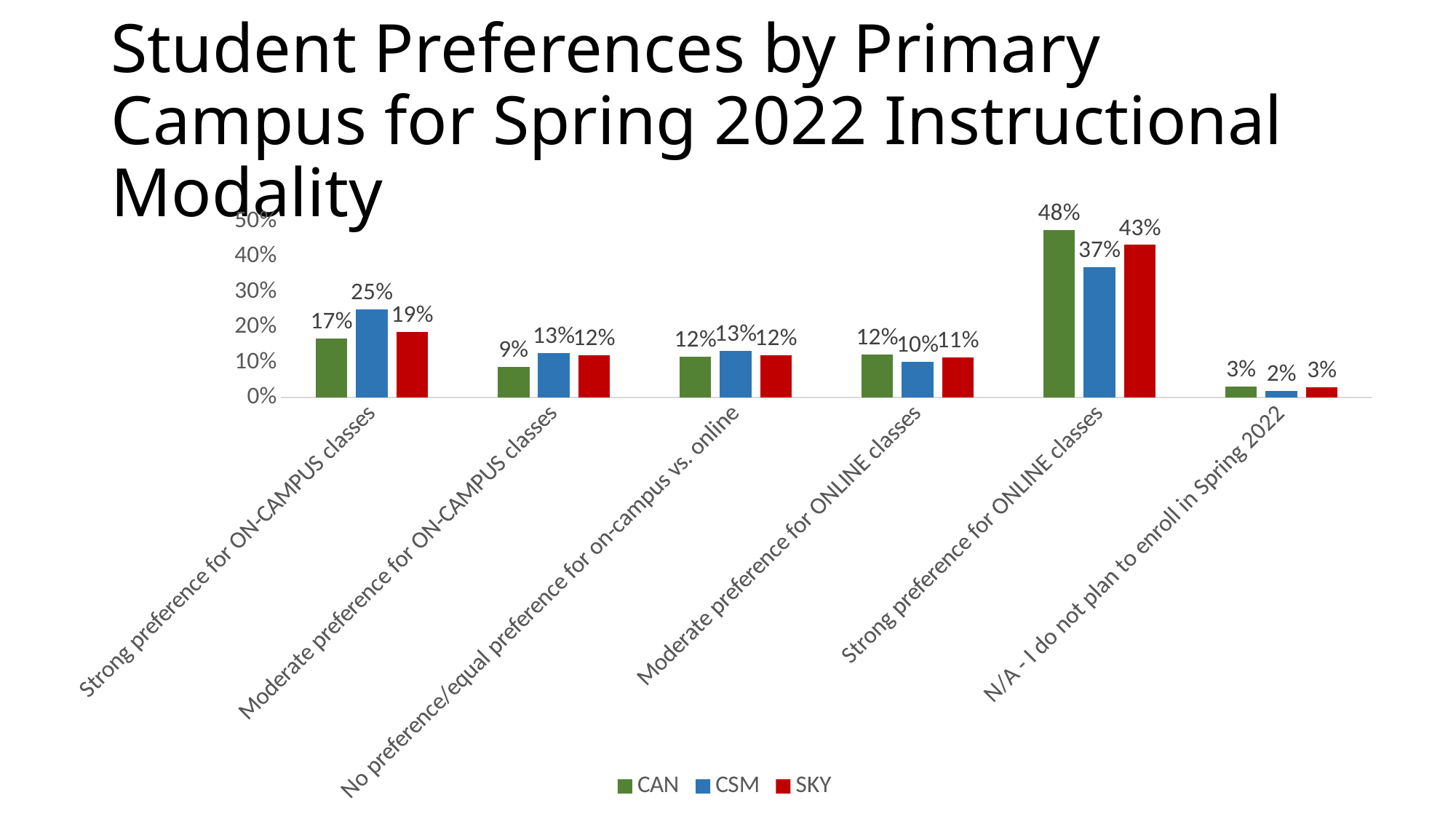
What is the CSM value for 'N/A - I do not plan to enroll in Spring 2022'? 2% What is the SKY value for 'Moderate preference for ON-CAMPUS classes'? 12% Which colour represents the SKY series? Red Which category has the highest CAN value? Strong preference for ONLINE classes For 'Strong preference for ON-CAMPUS classes', which is larger, the CAN value or the CSM value? CSM How many categories are shown on the x axis? 6 What is the CSM value for 'Strong preference for ON-CAMPUS classes'? 25% What is the CAN value for 'Strong preference for ONLINE classes'? 48% Which category has the lowest SKY value? N/A - I do not plan to enroll in Spring 2022 How many series does the legend list? 3 What kind of chart is shown on the slide? Bar chart What is the difference between the CAN and CSM values for 'Strong preference for ONLINE classes'? 11%